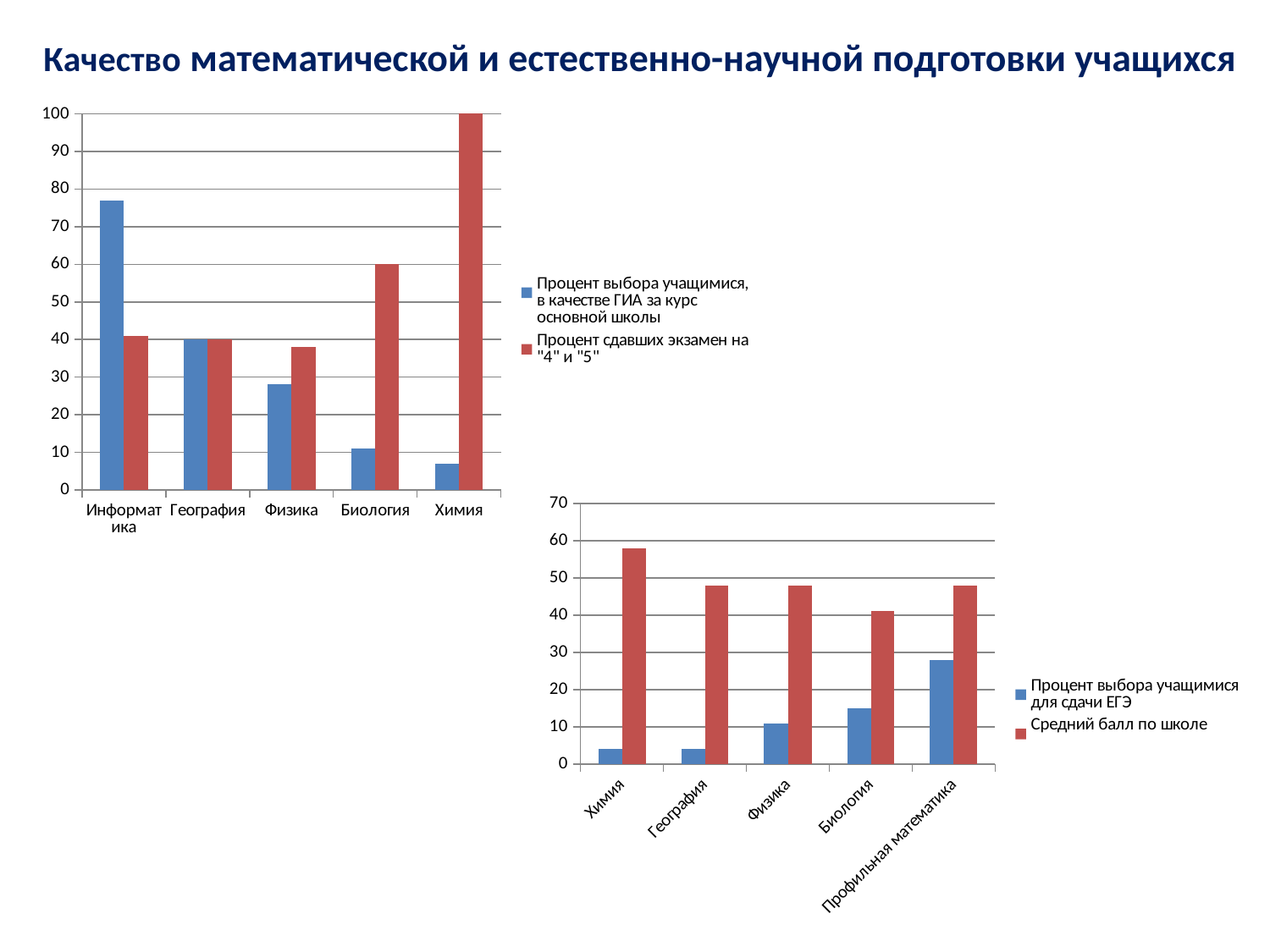
On the bottom-right chart, which category has the highest value for the blue series (Процент выбора учащимися для сдачи ЕГЭ)? Профильная математика What type of chart is the bottom-right chart? Bar chart On the top-left chart, is the value of the blue series for Информатика greater or less than 70? greater On the bottom-right chart, is the value of the red series (Средний балл по школе) for Биология greater or less than 50? less On the top-left chart, which category has the highest value for the blue series (Процент выбора учащимися, в качестве ГИА за курс основной школы)? Информатика On the top-left chart, which category has the lowest value for the blue series (Процент выбора учащимися, в качестве ГИА за курс основной школы)? Химия On the top-left chart, what is the value of the red series (Процент сдавших экзамен на "4" и "5") for Химия? 100 On the top-left chart, what is the value of the red series (Процент сдавших экзамен на "4" и "5") for Биология? 60 On the top-left chart, how many categories are shown on the x axis? 5 On the bottom-right chart, which category has the highest value for the red series (Средний балл по школе)? Химия On the bottom-right chart, how many series does the legend list? 2 On the top-left chart, what is the value of the blue series (Процент выбора учащимися, в качестве ГИА за курс основной школы) for География? 40